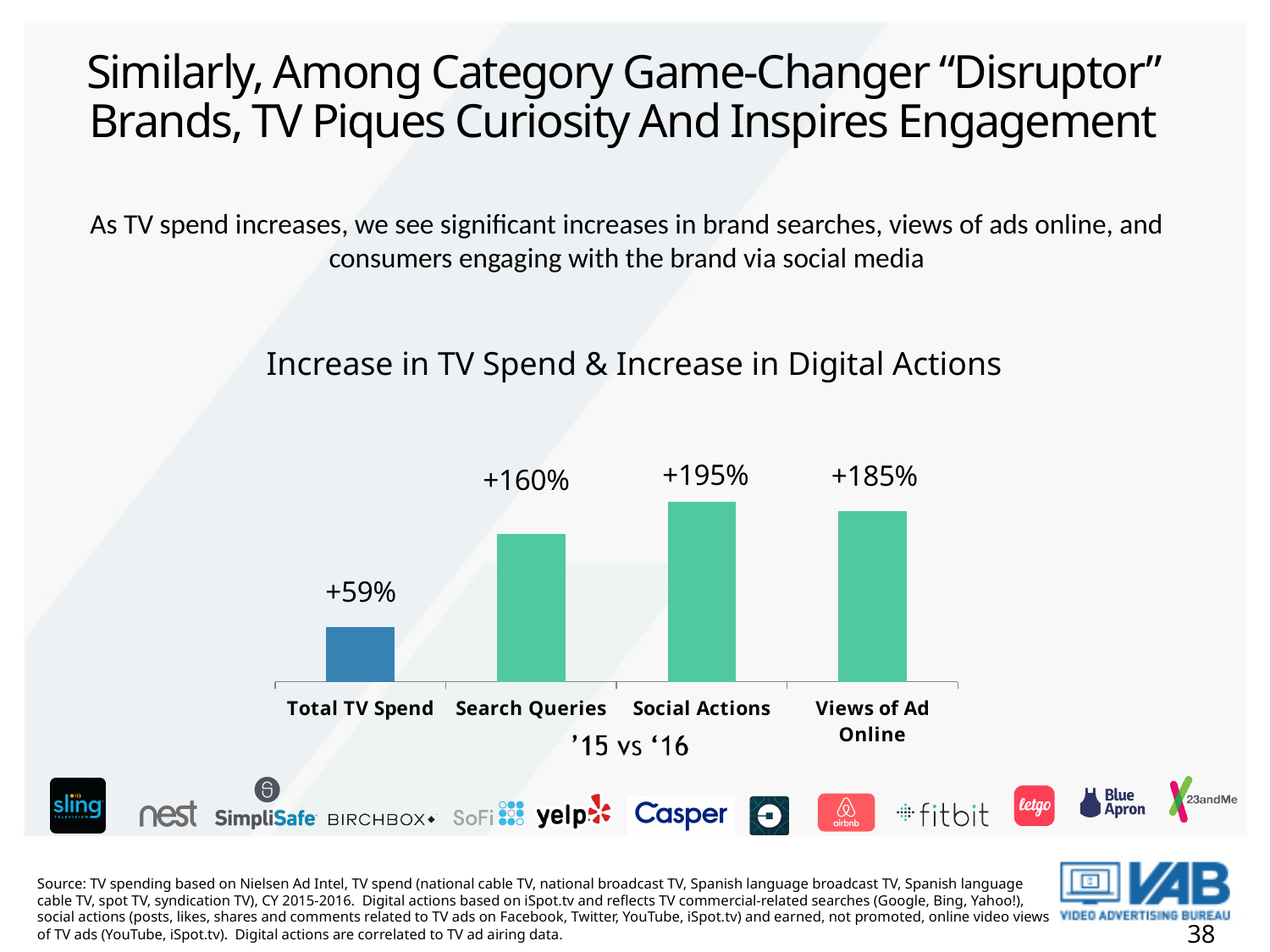
What is the title of the chart? Increase in TV Spend & Increase in Digital Actions What is the value for Total TV Spend? +59% How many categories are shown in the chart? 4 What is the value for Search Queries? +160% What kind of chart is shown on the slide? Bar chart What is the value for Views of Ad Online? +185% Which category has the lowest value? Total TV Spend What is the difference between the values for Search Queries and Views of Ad Online? 25 percentage points What is the value for Social Actions? +195% Which is larger, the value for Social Actions or the value for Views of Ad Online? Social Actions Which category has the highest value? Social Actions What is the difference between the values for Social Actions and Total TV Spend? 136 percentage points